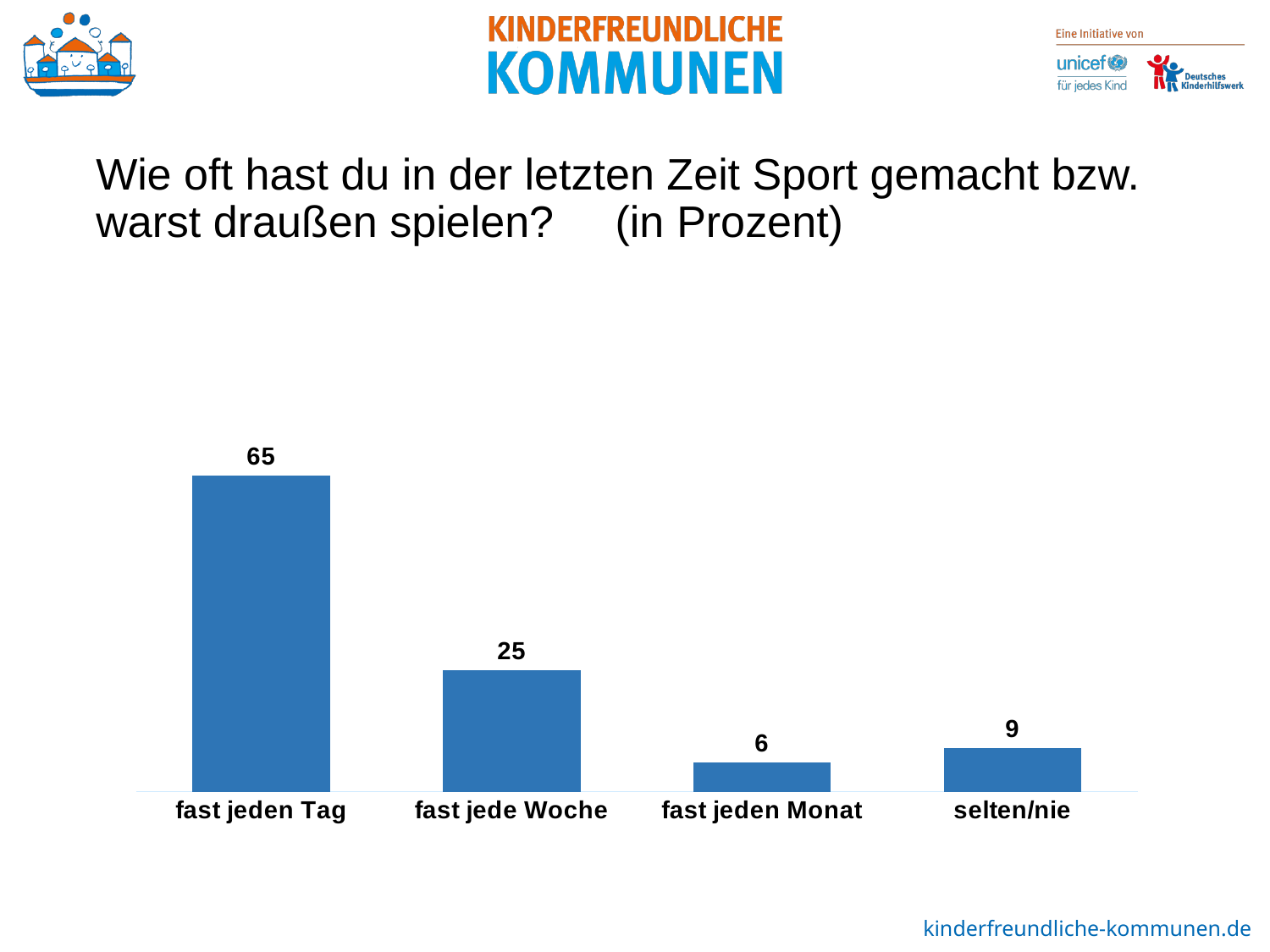
What is the difference between the values for "selten/nie" and "fast jeden Monat"? 3 What is the value for "fast jede Woche"? 25 What is the difference between the values for "fast jeden Tag" and "fast jede Woche"? 40 How many categories are shown in the chart? 4 What is the value for "fast jeden Monat"? 6 Which is larger, the value for "selten/nie" or the value for "fast jeden Monat"? selten/nie What kind of chart is shown on the slide? bar chart Which category has the lowest value? fast jeden Monat What is the value for "fast jeden Tag"? 65 What is the value for "selten/nie"? 9 Which category has the highest value? fast jeden Tag What unit are the values in the chart given in, according to the slide title? Prozent